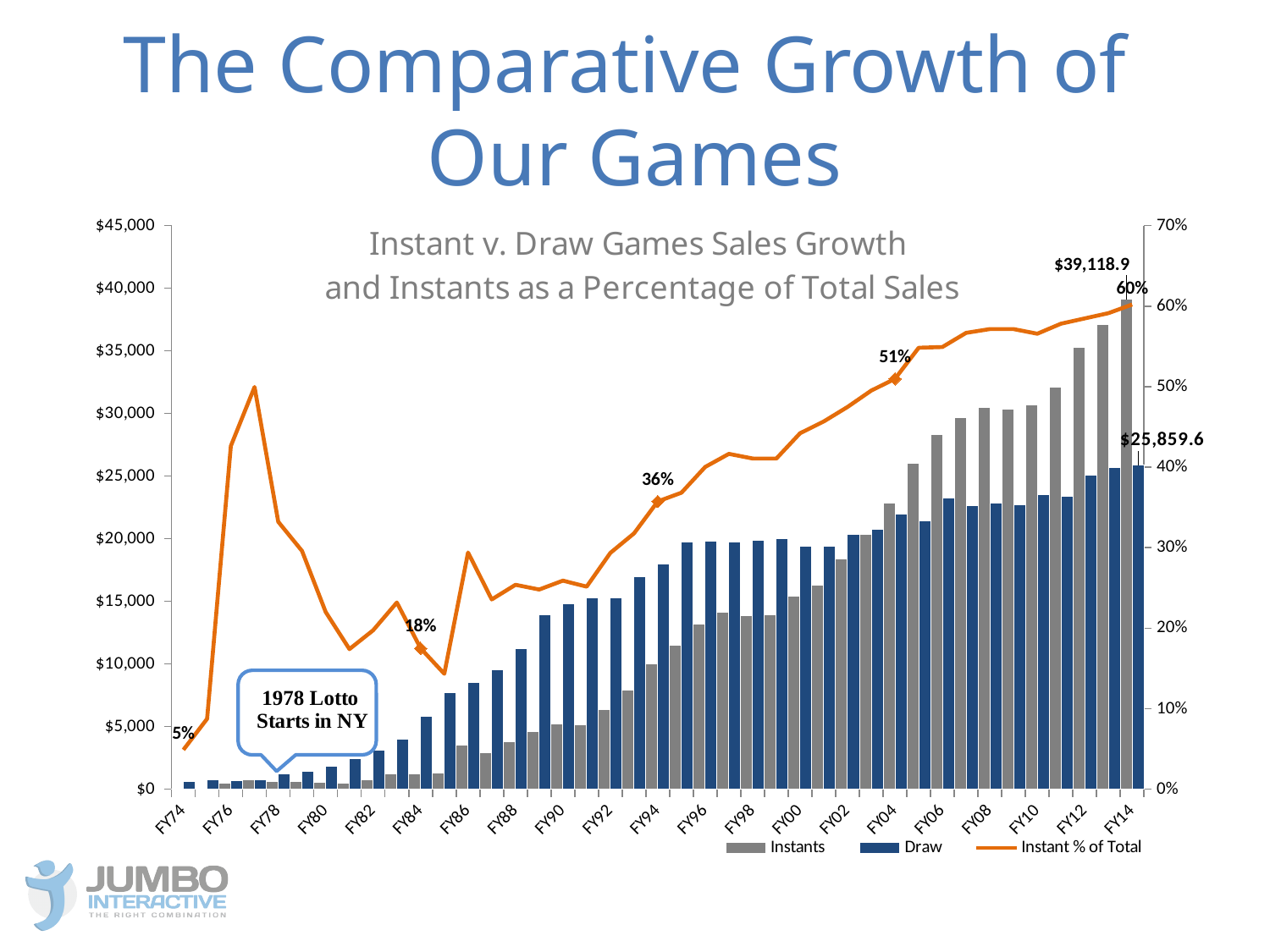
What is the Instant % of Total value labelled for FY14? 60% Which is larger in FY14, the Instants bar or the Draw bar? Instants What kind of chart is shown on the slide? Bar and line chart Is the Instants value for FY06 greater or less than $25,000? greater What is the Instant % of Total value labelled for FY94? 36% What is the labelled value of the Instants bar for FY14? $39,118.9 What is the Instant % of Total value labelled for FY04? 51% What event does the callout annotation on the chart describe? 1978 Lotto Starts in NY What is the Instant % of Total value labelled for FY74? 5% By how much does the FY14 Instants value exceed the FY14 Draw value? $13,259.3 What is the labelled value of the Draw bar for FY14? $25,859.6 How many series does the legend list? 3